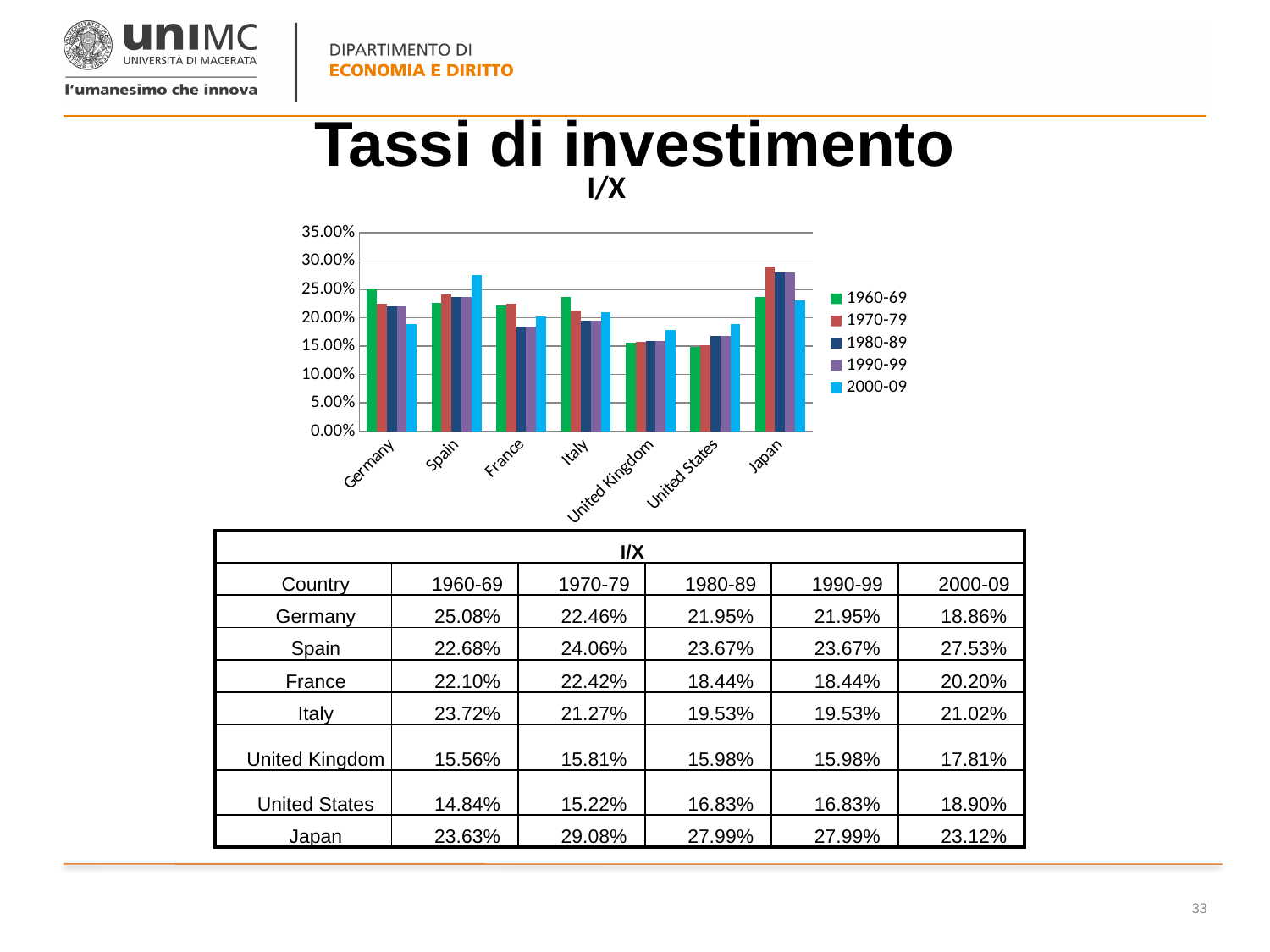
Do the values for the United States rise or fall from the 1960-69 series to the 2000-09 series? rise How many countries are shown on the x axis of the chart? 7 How many series does the chart legend list? 5 Which is larger, the 2000-09 value for Spain or the 2000-09 value for Japan? Spain What is the value for Spain in the 2000-09 series? 27.53% Which country has the lowest value in the 1960-69 series? United States Which country has the highest value in the 1960-69 series? Germany What is the difference between Germany's 1960-69 value and its 2000-09 value? 6.22% What is the title of the chart? I/X What is the value for Japan in the 1970-79 series? 29.08% Is the value for Japan in the 1970-79 series greater or less than 25.00%? greater What type of chart is shown on the slide? bar chart